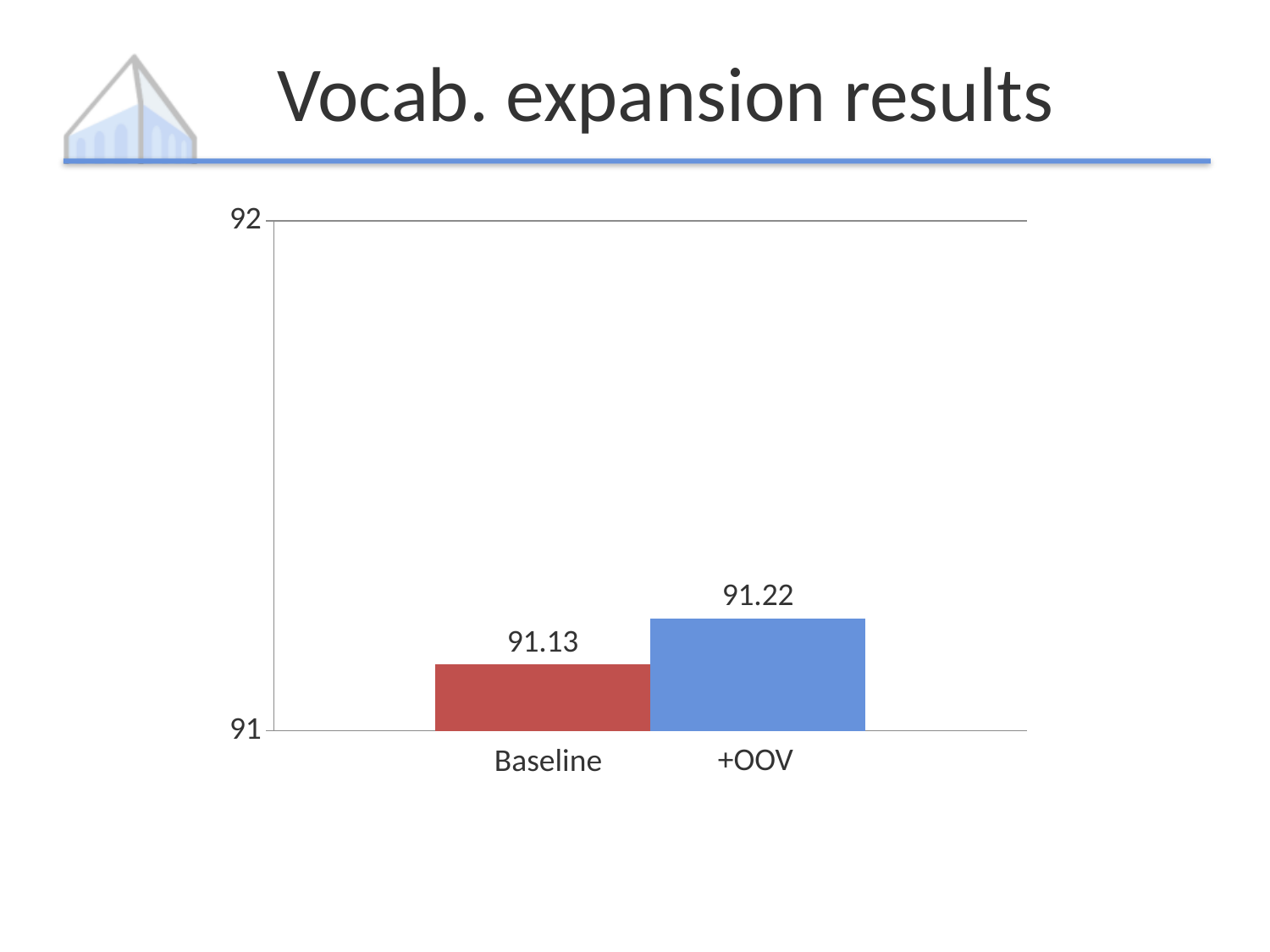
Which category has the highest value? +OOV What kind of chart is shown on the slide? bar chart What is the difference between the +OOV value and the Baseline value? 0.09 Is the value for +OOV greater or less than 92? less What is the value for Baseline? 91.13 Do the values rise or fall from Baseline to +OOV? rise What is the title of the slide containing the chart? Vocab. expansion results How many categories are shown in the chart? 2 What is the value for +OOV? 91.22 Which is larger, the value for Baseline or the value for +OOV? +OOV Is the value for Baseline greater or less than 91? greater Which category has the lowest value? Baseline